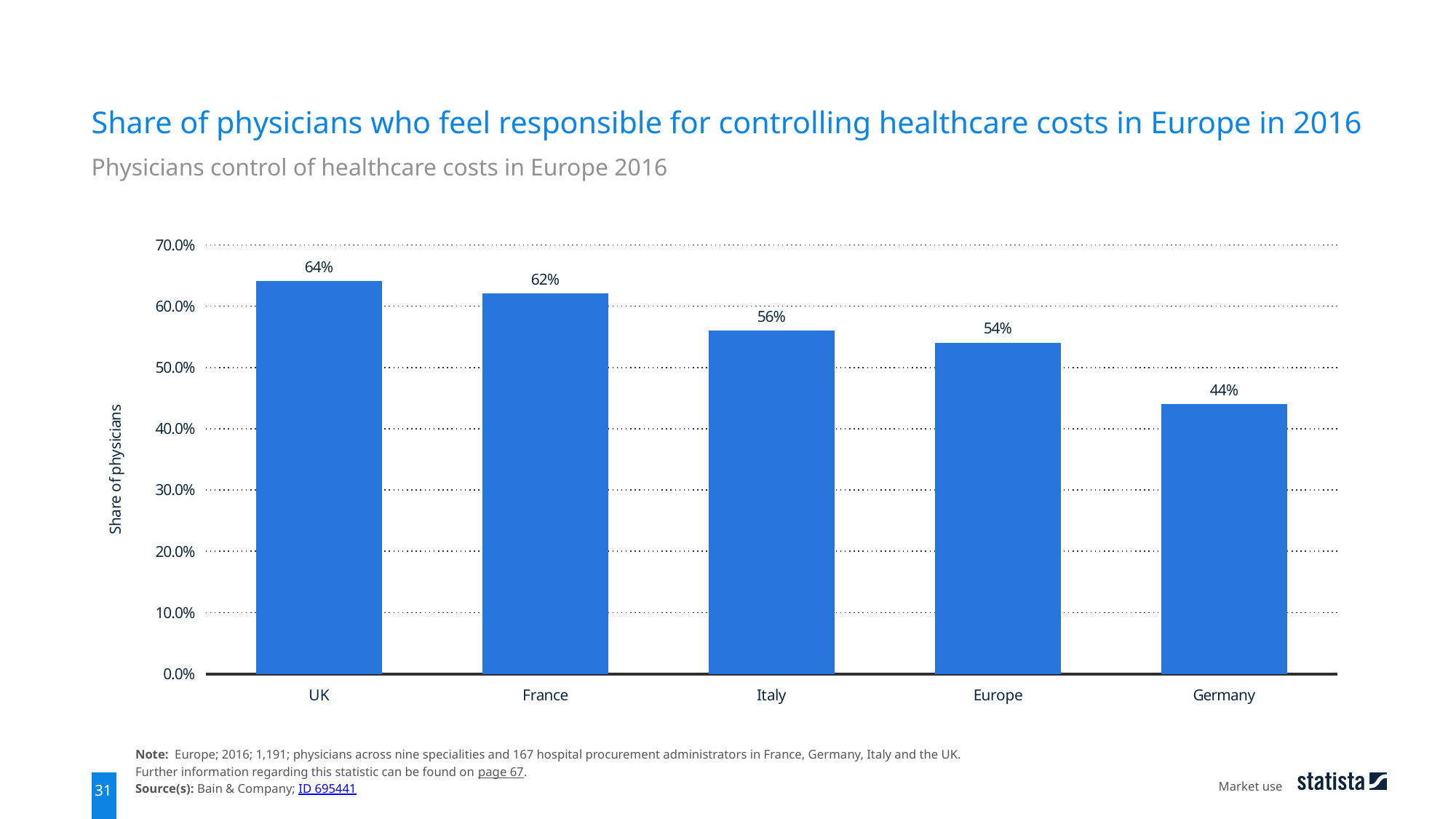
Which category has the lowest share of physicians? Germany What is the share of physicians for Germany? 44% What kind of chart is shown on the slide? Bar chart Is the value for France greater or less than 50.0%? greater Which has a larger share of physicians, Italy or Europe? Italy How many categories are shown on the x axis? 5 What is the difference between the share for the UK and the share for Germany? 20% What is the difference between the share for France and the share for Europe? 8% What is the label of the y axis? Share of physicians Which category has the highest share of physicians? UK What is the share of physicians for the UK? 64% What is the share of physicians for Italy? 56%